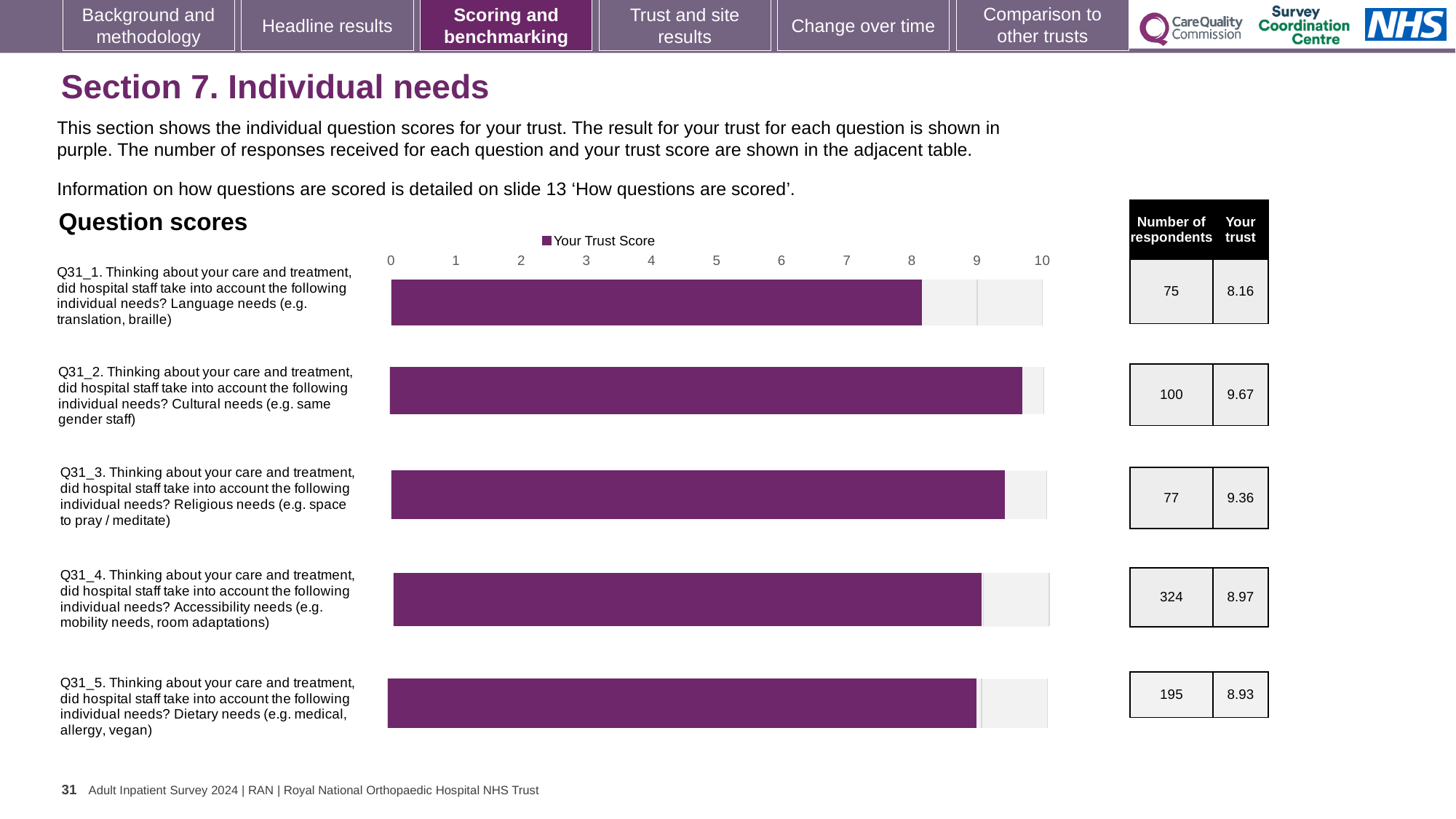
Is the trust score for Q31_2 greater or less than 9? greater Which has the higher trust score, Q31_3 (Religious needs) or Q31_4 (Accessibility needs)? Q31_3 (Religious needs) What is the trust score for Q31_2 (Cultural needs)? 9.67 What is the trust score for Q31_5 (Dietary needs)? 8.93 Which question has the highest trust score? Q31_2 (Cultural needs) What kind of chart is shown on the slide? Bar chart How many questions are plotted in the chart? 5 How many respondents answered Q31_4 (Accessibility needs)? 324 What is the difference between the trust scores for Q31_2 and Q31_1? 1.51 How many series does the chart legend list? 1 What is the name of the series shown in the chart legend? Your Trust Score Which question has the lowest trust score? Q31_1 (Language needs)